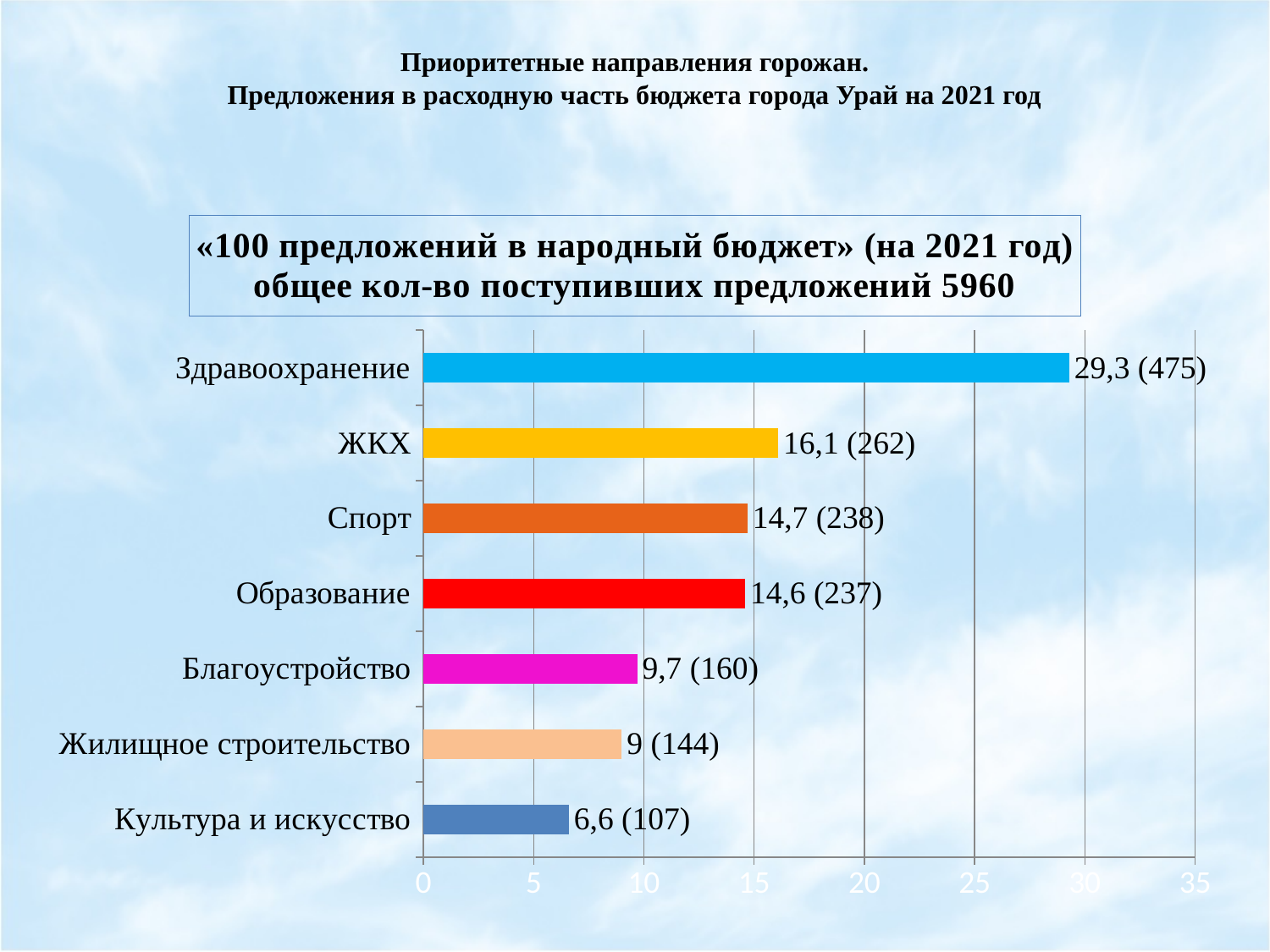
Which is larger, the value for Спорт or the value for Благоустройство? Спорт Which category has the highest value? Здравоохранение How many categories are shown in the chart? 7 What is the difference between the percentage values for Благоустройство and Жилищное строительство? 0,7 What is the data label for ЖКХ? 16,1 (262) Is the value for Культура и искусство greater or less than 10? less What is the data label for Здравоохранение? 29,3 (475) What kind of chart is shown on the slide? bar chart What is the difference between the number of proposals in parentheses for Здравоохранение and ЖКХ? 213 Which category has the lowest value? Культура и искусство What is the data label for Жилищное строительство? 9 (144) What is the data label for Культура и искусство? 6,6 (107)